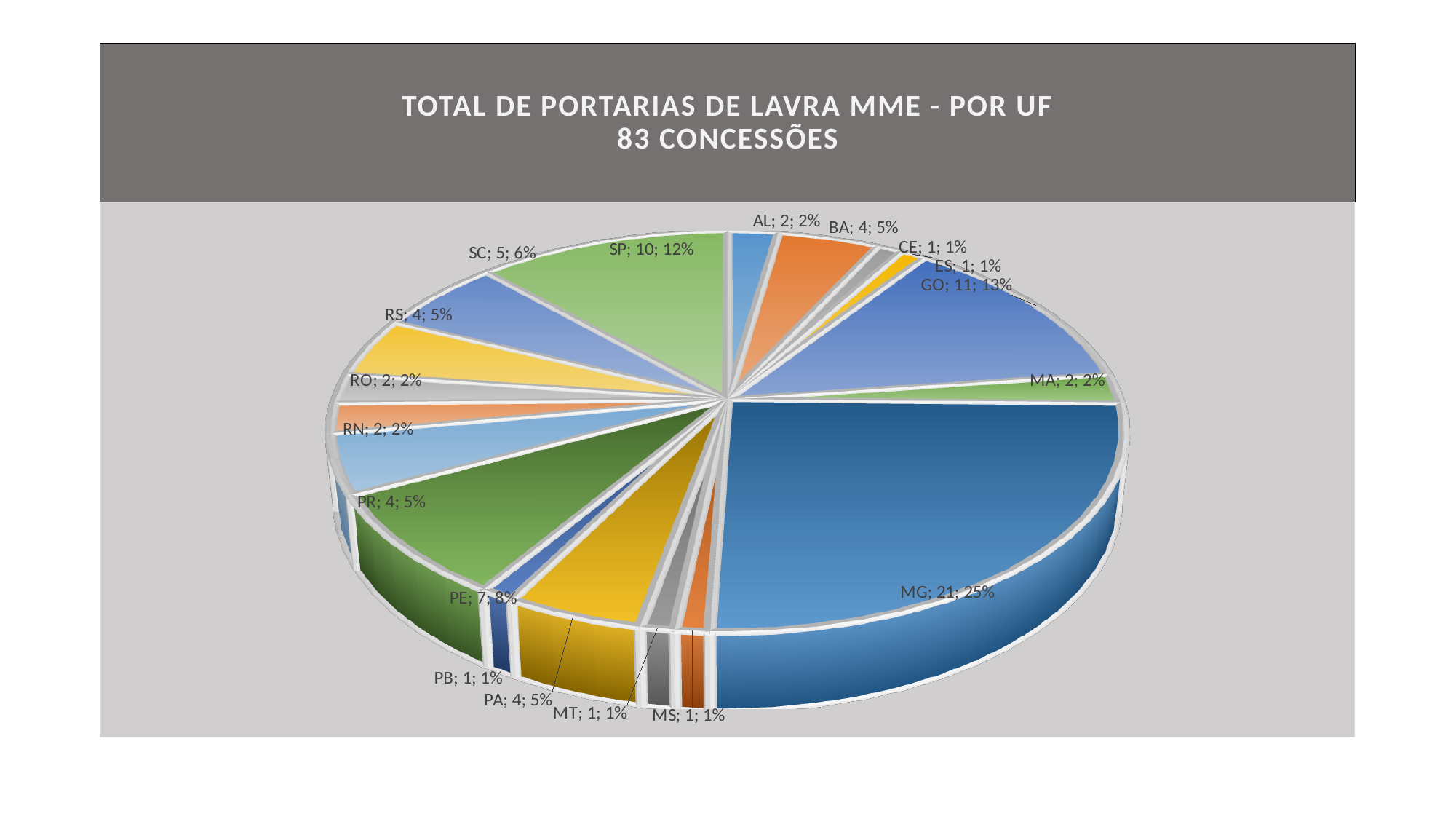
What share of the pie does GO represent? 13% How many concessions does MG have? 21 What is the difference in concessions between MG and GO? 10 What is the difference in concessions between SP and SC? 5 How many concessions does RS have? 4 What type of chart is shown on the slide? pie chart What share of the pie does PE represent? 8% How many concessions does SP have? 10 Which UF has the largest slice of the pie? MG Which has more concessions, PE or SC? PE What is the total number of concessions stated in the chart title? 83 How many UF categories are shown in the pie chart? 18